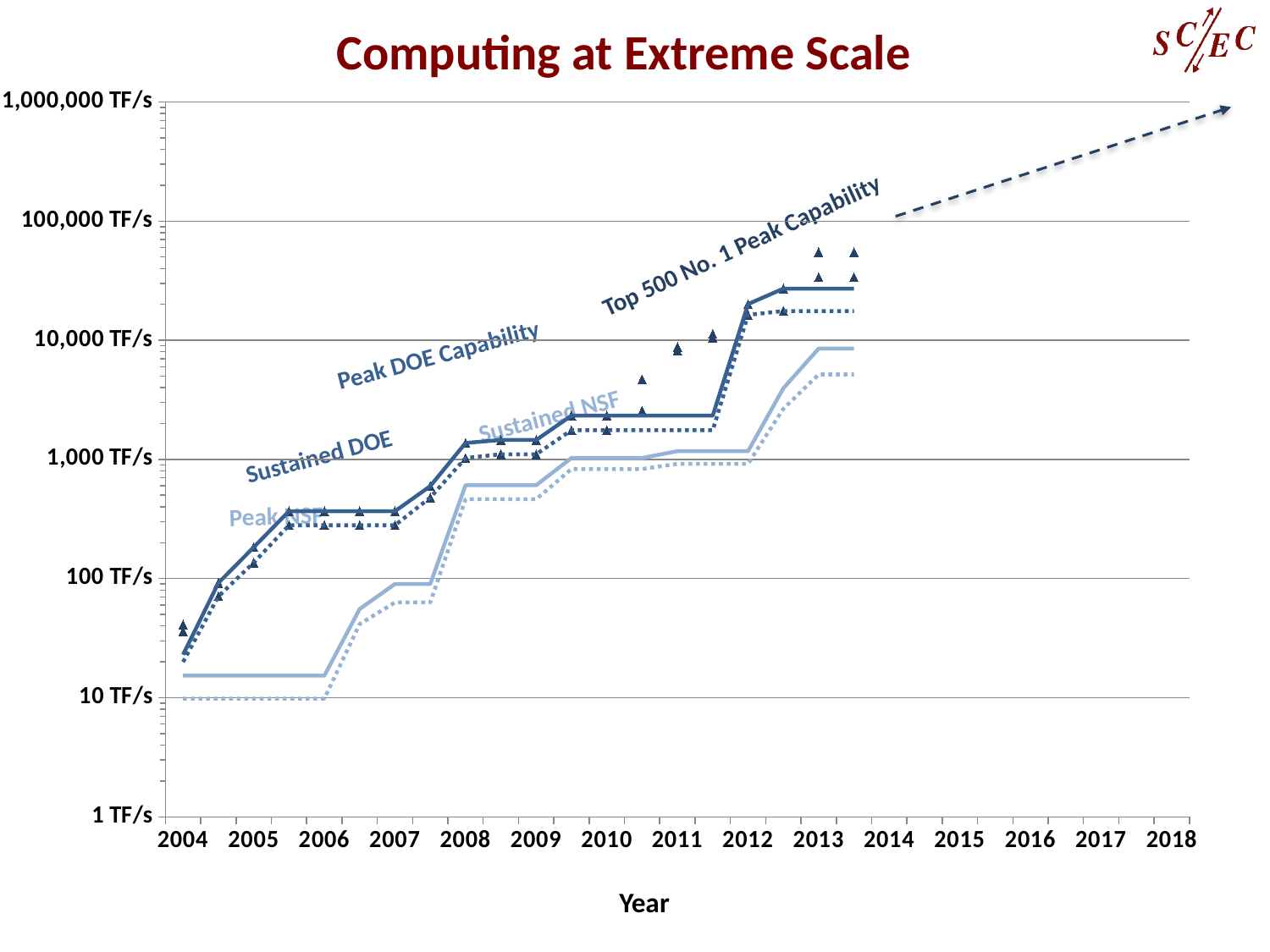
What is the title of the chart? Computing at Extreme Scale How many named series are labelled on the chart? 5 Is the Sustained DOE value in 2006 greater or less than 100 TF/s? greater How many year ticks are shown on the x axis? 15 In 2013, which is higher: Peak DOE Capability or Peak NSF? Peak DOE Capability What kind of chart is shown on the slide? Line chart What is the label of the x axis? Year Which series has the lowest values in 2004? Sustained NSF Is the Peak NSF value in 2004 greater or less than 100 TF/s? less Is the Peak DOE Capability value in 2013 greater or less than 10,000 TF/s? greater Do the Peak DOE Capability values rise or fall from 2004 to 2013? Rise